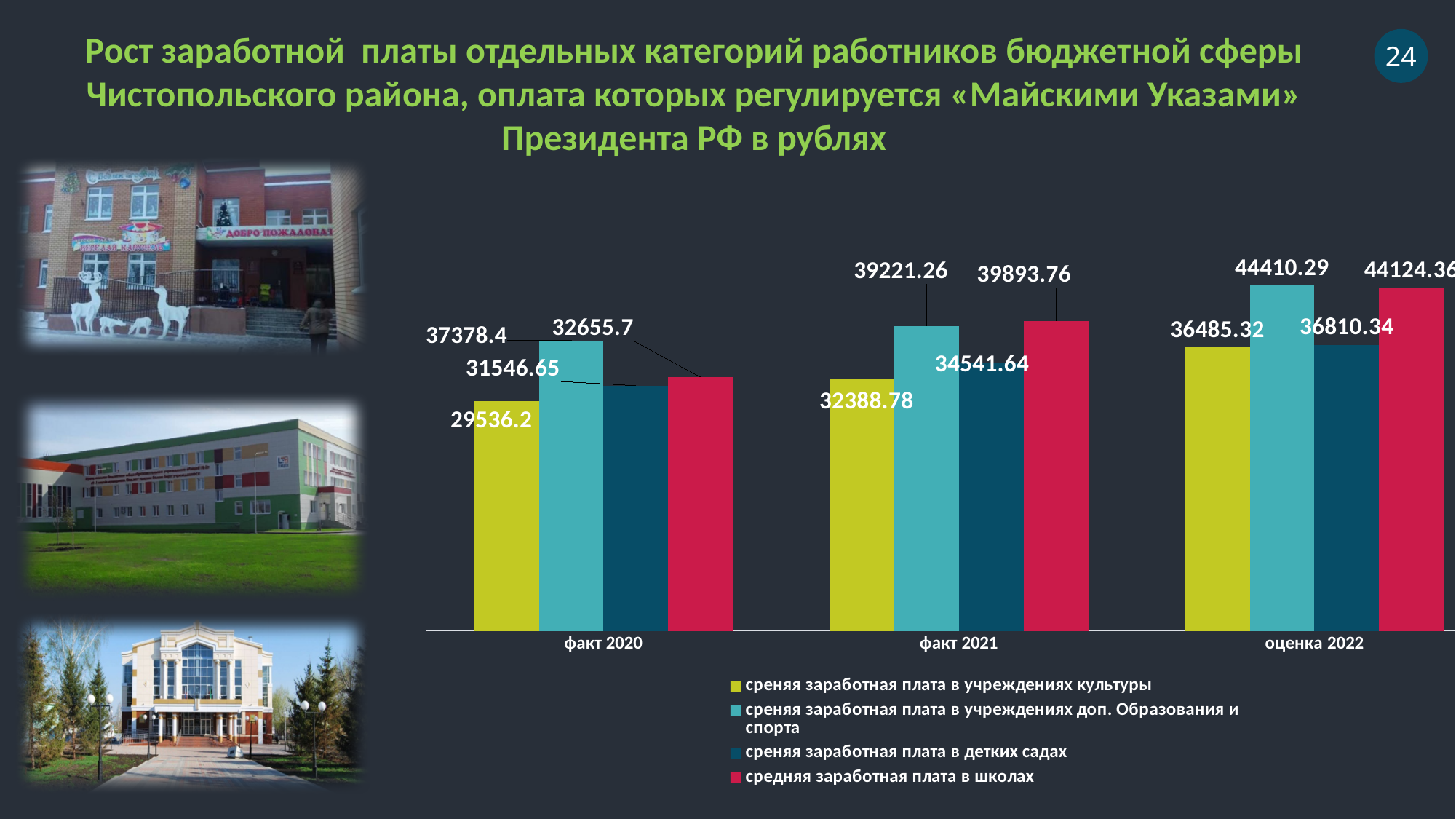
By how much does the average salary in schools for оценка 2022 exceed that for факт 2021? 4230.6 What is the average salary in institutions of additional education and sport (доп. Образования и спорта) for оценка 2022? 44410.29 How many series does the legend list? 4 What kind of chart is shown on the slide? bar chart For факт 2020, which is larger: the average salary in kindergartens or in schools? в школах How many periods (categories) are shown on the x axis? 3 For факт 2021, which category of workers has the lowest average salary? учреждения культуры What is the difference between the average salary in cultural institutions for факт 2021 and факт 2020? 2852.58 What is the average salary in schools (в школах) for факт 2021? 39893.76 For оценка 2022, which category of workers has the highest average salary? учреждения доп. Образования и спорта What is the average salary in kindergartens (в детских садах) for факт 2021? 34541.64 What is the average salary in cultural institutions (учреждениях культуры) for факт 2020? 29536.2